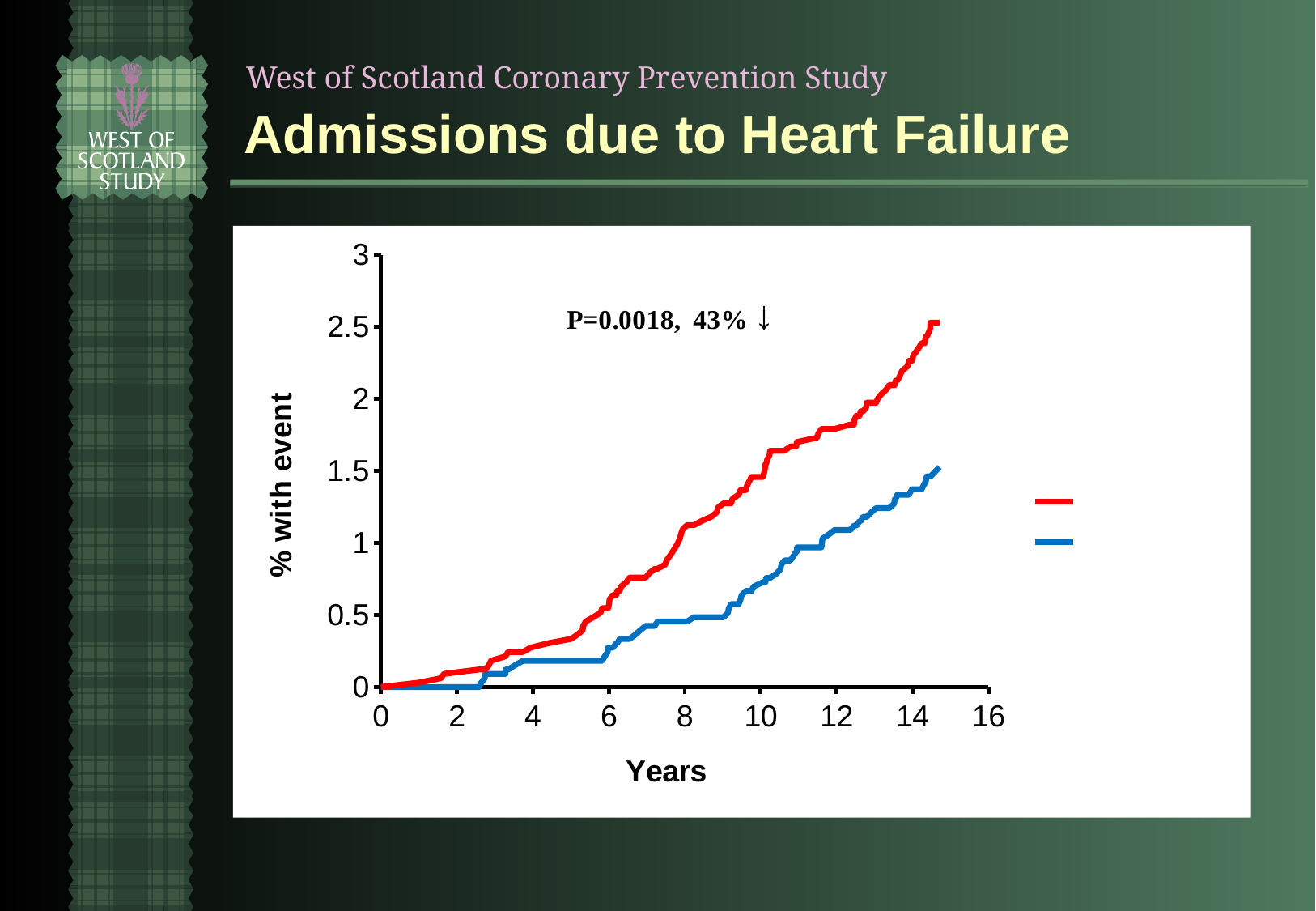
Do the values of the red line rise or fall as the years increase? rise Is the value of the red line at year 12 greater or less than 1.5? greater What P value is printed on the chart? P=0.0018 What is the label of the y axis? % with event Is the value of the red line at year 14 greater or less than 2? greater How many series does the legend list? 2 Is the value of the blue line at year 12 greater or less than 1.5? less At year 10, which line is higher, the red line or the blue line? red line Do the values of the blue line rise or fall as the years increase? rise What kind of chart is shown on the slide? line chart